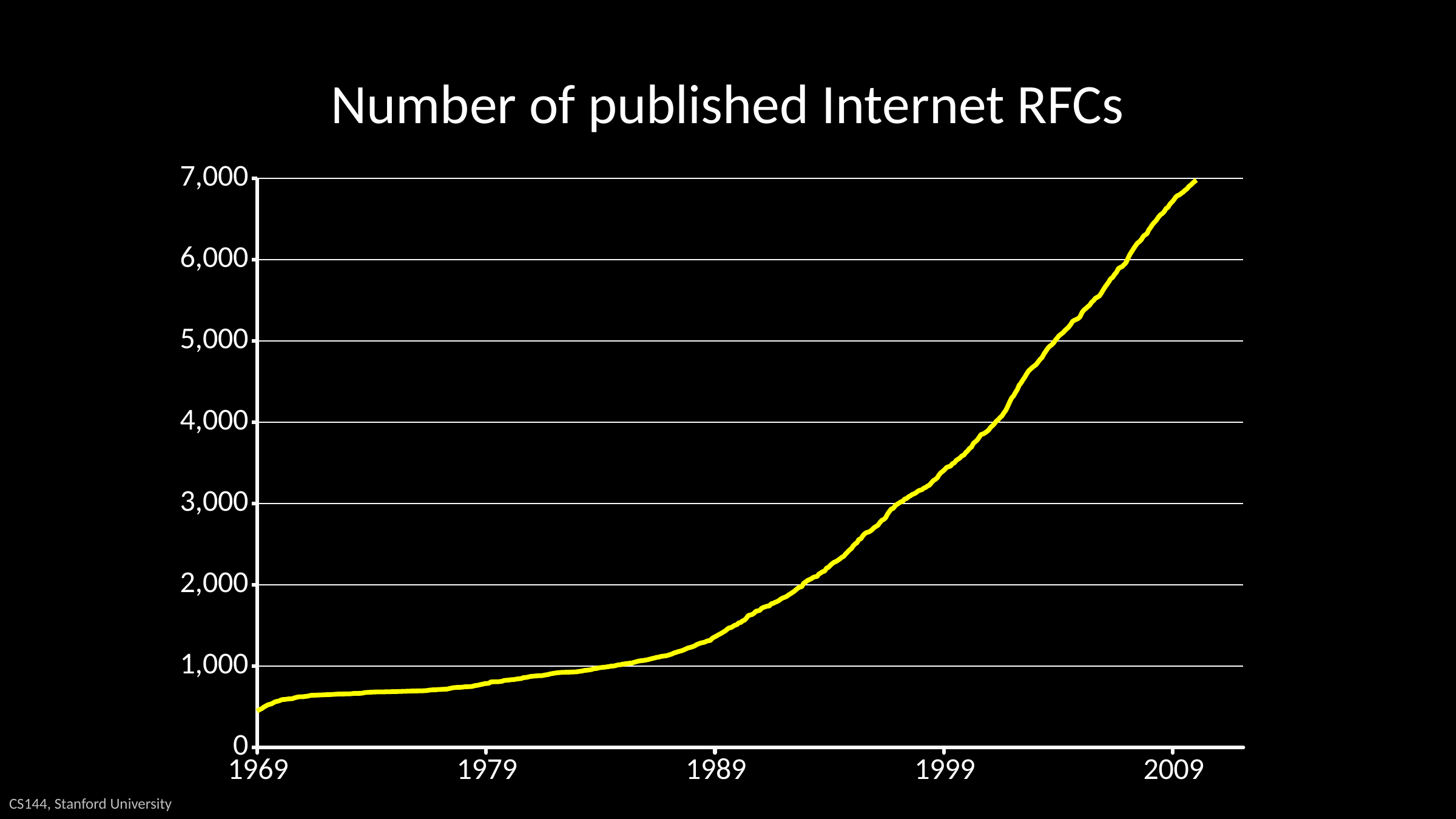
Is the value for 2009 greater or less than 6,000? greater How many year labels are shown on the x axis? 5 Which labelled year on the x axis has the higher value, 1979 or 1999? 1999 Is the value for 1969 greater or less than 1,000? less What colour is the plotted line? yellow What kind of chart is shown on the slide? line chart Do the values rise or fall from 1969 to 2009? rise Which labelled year on the x axis has the lowest value? 1969 Is the value for 1999 greater or less than 2,000? greater What is the title of the chart? Number of published Internet RFCs